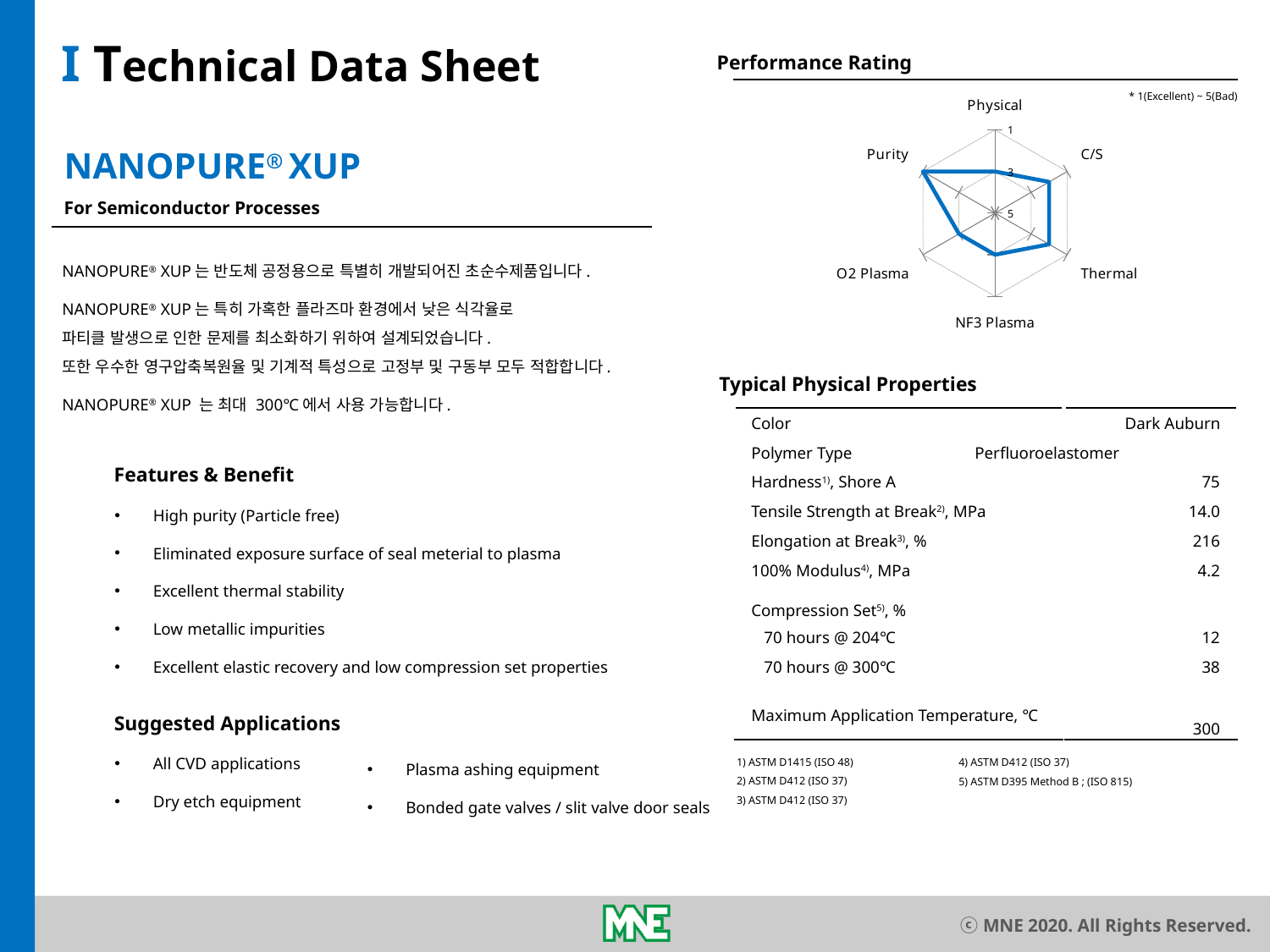
On the Performance Rating chart, which category is plotted at the top of the radar? Physical What is the title of the radar chart on the slide? Performance Rating What kind of chart is the Performance Rating chart? radar chart On the Performance Rating chart, is the rating for Purity greater or less than 3? less How many categories (axes) does the Performance Rating radar chart have? 6 On the Performance Rating chart, is the rating for C/S greater or less than 3? less On the Performance Rating chart, is the rating for Thermal greater or less than 3? less On the Performance Rating chart, what rating value is labelled as Excellent? 1 On the Performance Rating chart, which category has the best (lowest) rating, extending furthest from the center? Purity